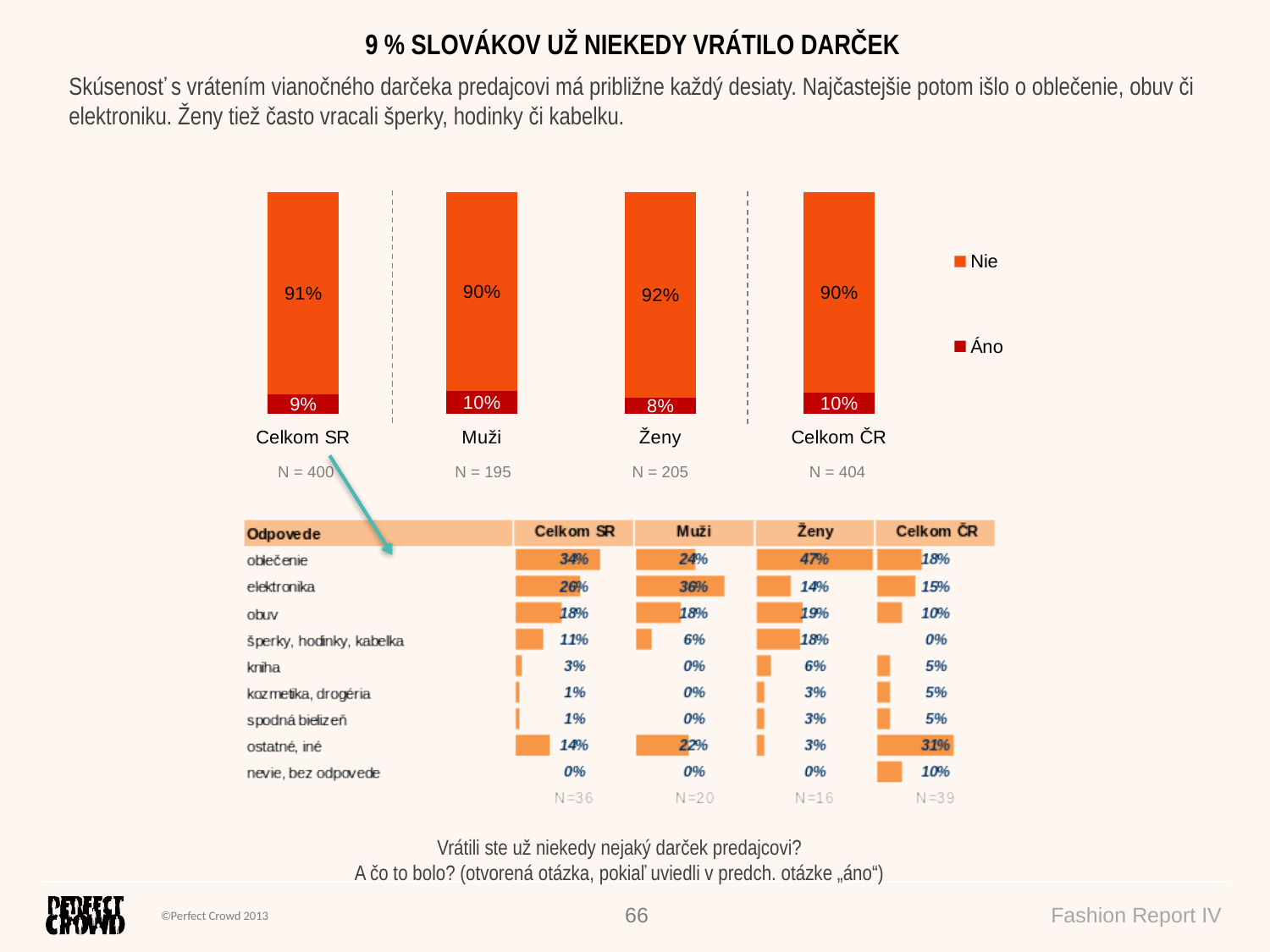
In the 'Odpovede' chart below, what is the difference between 'obuv' for Ženy and 'obuv' for Celkom ČR? 9% What type of chart is shown at the top of the slide? Stacked bar chart In the 'Odpovede' chart below, what is the value for 'oblečenie' in the Ženy column? 47% In the 'Odpovede' chart below, which is larger for Muži: 'oblečenie' or 'elektronika'? elektronika In the stacked bar chart at the top, what is the 'Nie' value for Celkom SR? 91% In the stacked bar chart at the top, how many series does the legend list? 2 In the stacked bar chart at the top, what is the difference between the 'Nie' values for Ženy and Celkom ČR? 2% In the stacked bar chart at the top, how many groups (bars) are shown? 4 In the stacked bar chart at the top, which group has the lowest 'Áno' share? Ženy In the stacked bar chart at the top, what is the total of the Muži bar (Nie plus Áno)? 100% In the 'Odpovede' chart below, which answer has the highest value in the Celkom ČR column? ostatné, iné In the stacked bar chart at the top, what is the 'Áno' value for Ženy? 8%